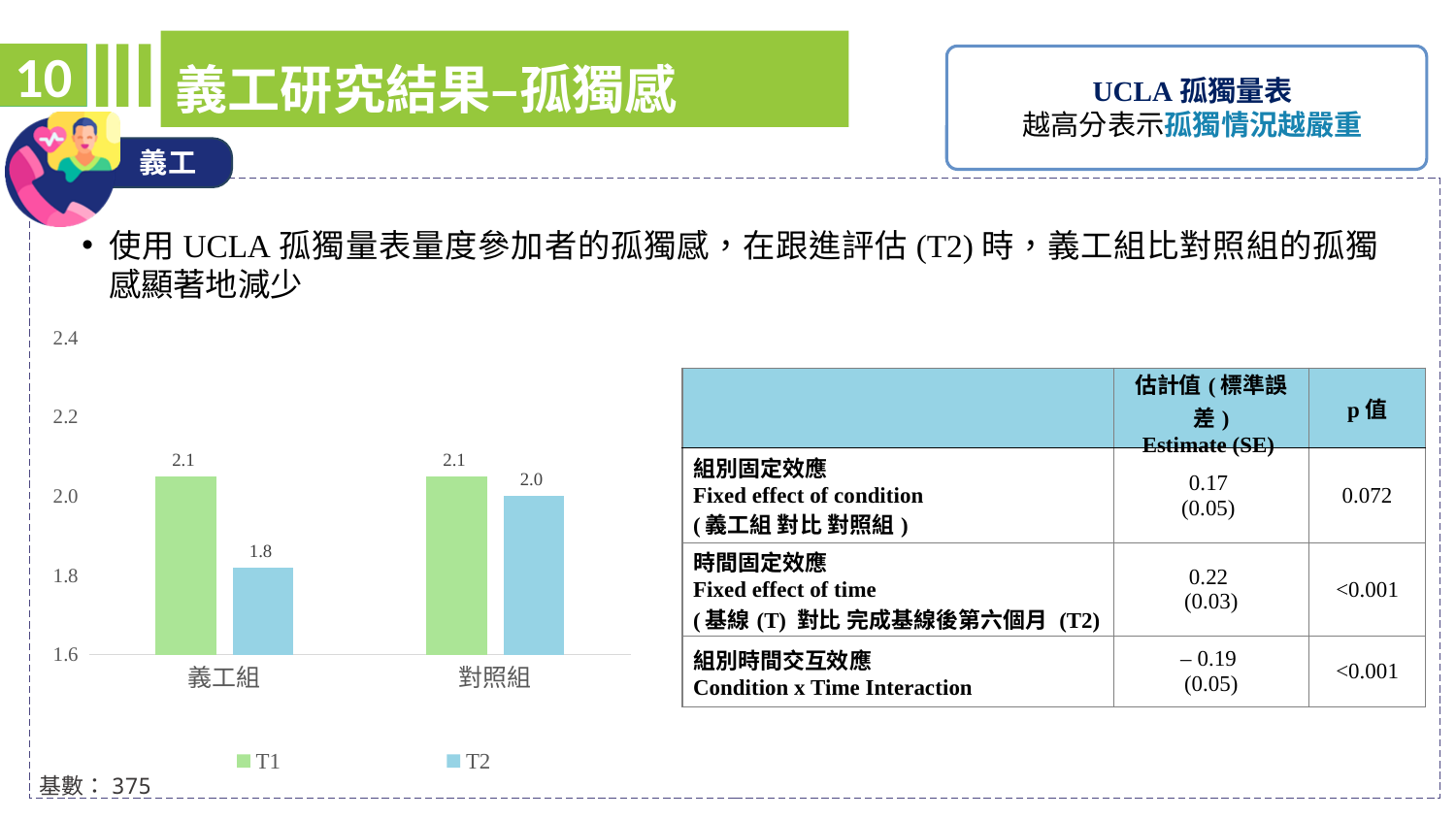
What is the difference between the T2 values of 對照組 and 義工組? 0.2 What is the T1 value for 義工組? 2.1 What kind of chart is shown on the slide? bar chart What is the T2 value for 對照組? 2.0 What is the T2 value for 義工組? 1.8 Is the T2 value for 義工組 greater or less than 2.0? less How many groups are shown on the x axis of the chart? 2 What is the T1 value for 對照組? 2.1 Which group has the larger T2 value, 義工組 or 對照組? 對照組 How many series does the chart legend list? 2 Which group has the lowest T2 value? 義工組 What is the difference between the T1 and T2 values for 義工組? 0.3